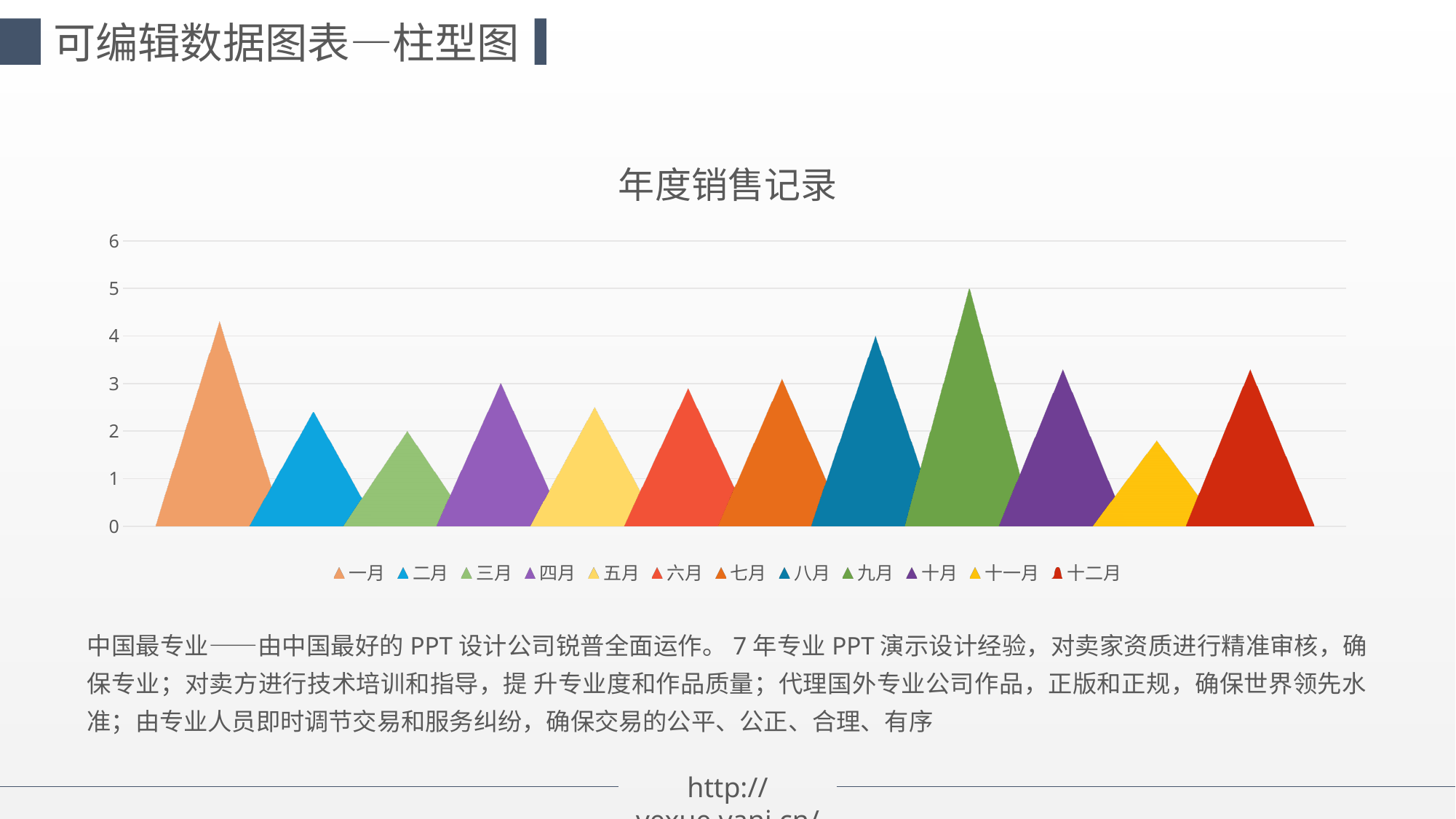
Is the value for 一月 greater or less than 4? greater Which month has the highest value in the chart? 九月 How many entries does the legend list? 12 What is the value for 九月? 5 Is the value for 三月 greater or less than 3? less What kind of chart is shown on the slide? bar chart How many months are plotted in the chart? 12 What is the title of the chart? 年度销售记录 Which is larger, the value for 一月 or the value for 二月? 一月 Which is larger, the value for 八月 or the value for 四月? 八月 Is the value for 十二月 greater or less than 3? greater